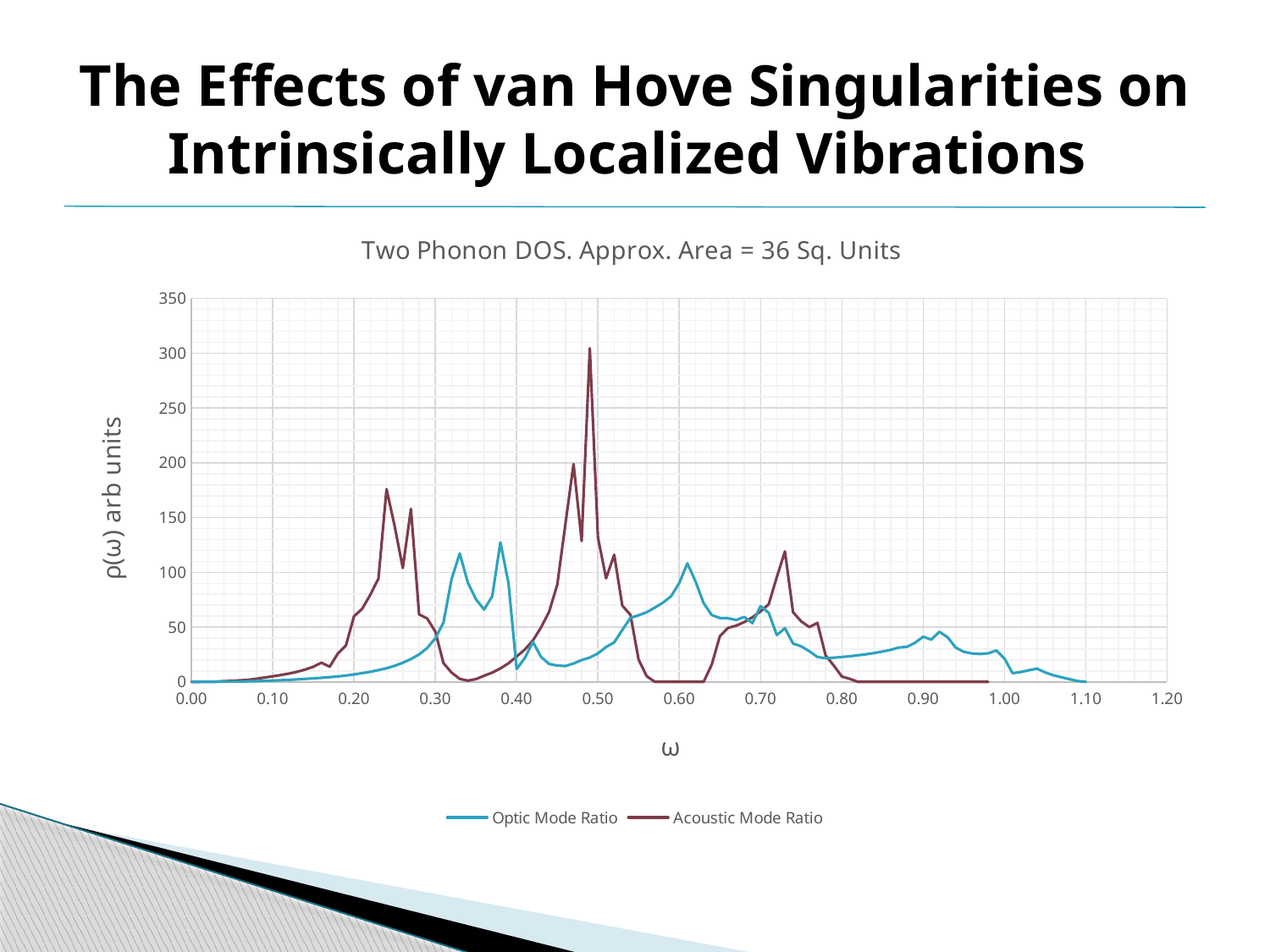
Which series extends further along the ω axis before reaching zero, Optic Mode Ratio or Acoustic Mode Ratio? Optic Mode Ratio How many series does the legend list? 2 What kind of chart is shown on the slide? line chart Is the highest peak of the Acoustic Mode Ratio series greater or less than 250? greater Is the Acoustic Mode Ratio value at ω = 0.60 greater or less than 50? less What is the highest value shown on the y axis? 350 Is the highest peak of the Optic Mode Ratio series greater or less than 150? less What is the label of the y axis? ρ(ω) arb units What is the title of the chart? Two Phonon DOS. Approx. Area = 36 Sq. Units Which series reaches the highest peak value on the chart? Acoustic Mode Ratio